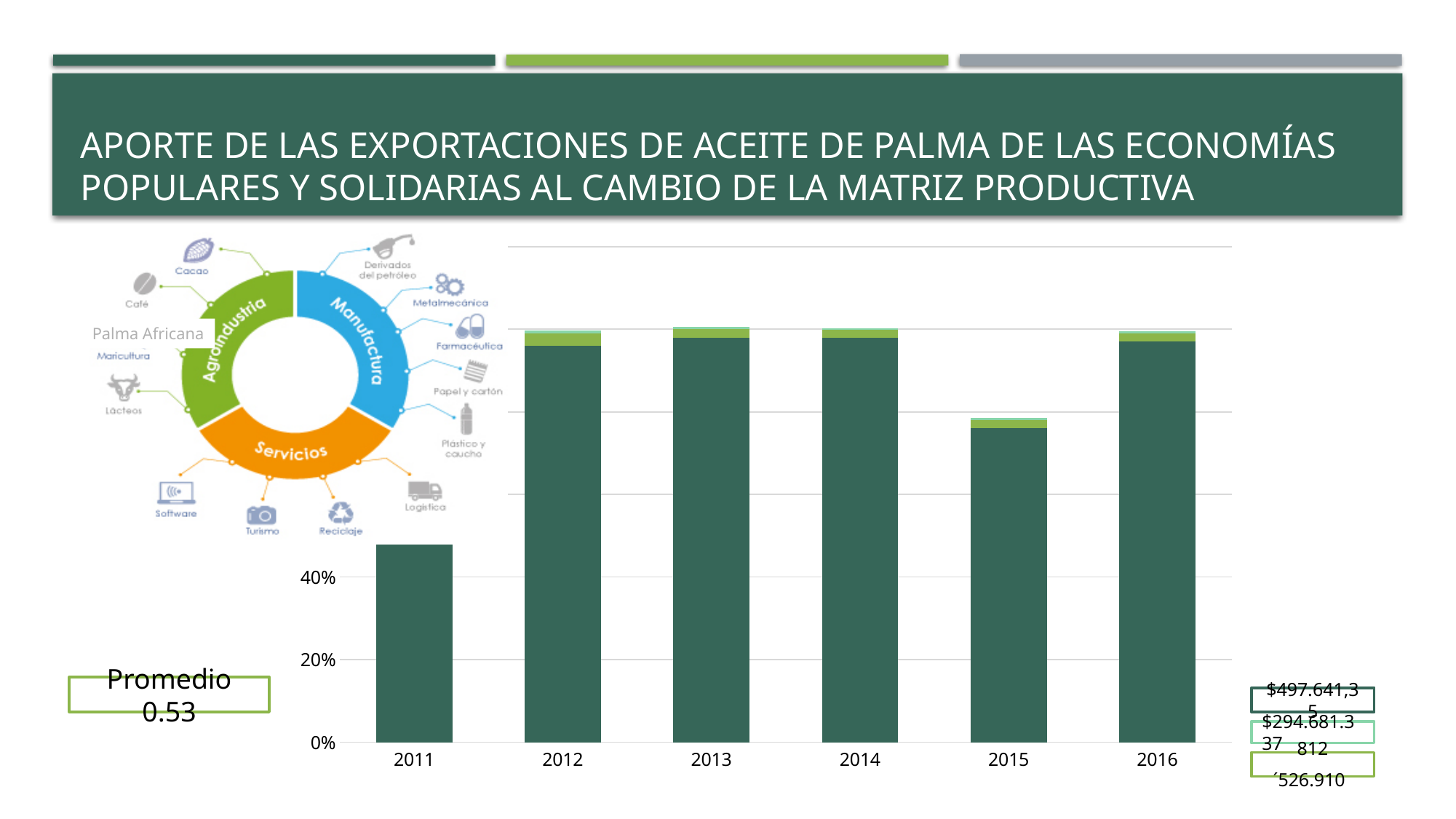
Does the bar height rise or fall from 2014 to 2015? fall Is the value for 2015 greater or less than 40%? greater What is the first year shown on the x axis of the chart? 2011 What kind of chart is shown on the slide? bar chart How many years are shown on the x axis of the bar chart? 6 Is the value for 2011 greater or less than 20%? greater Is the value for 2011 greater or less than 40%? greater What average (Promedio) value is printed in the box to the left of the chart? 0.53